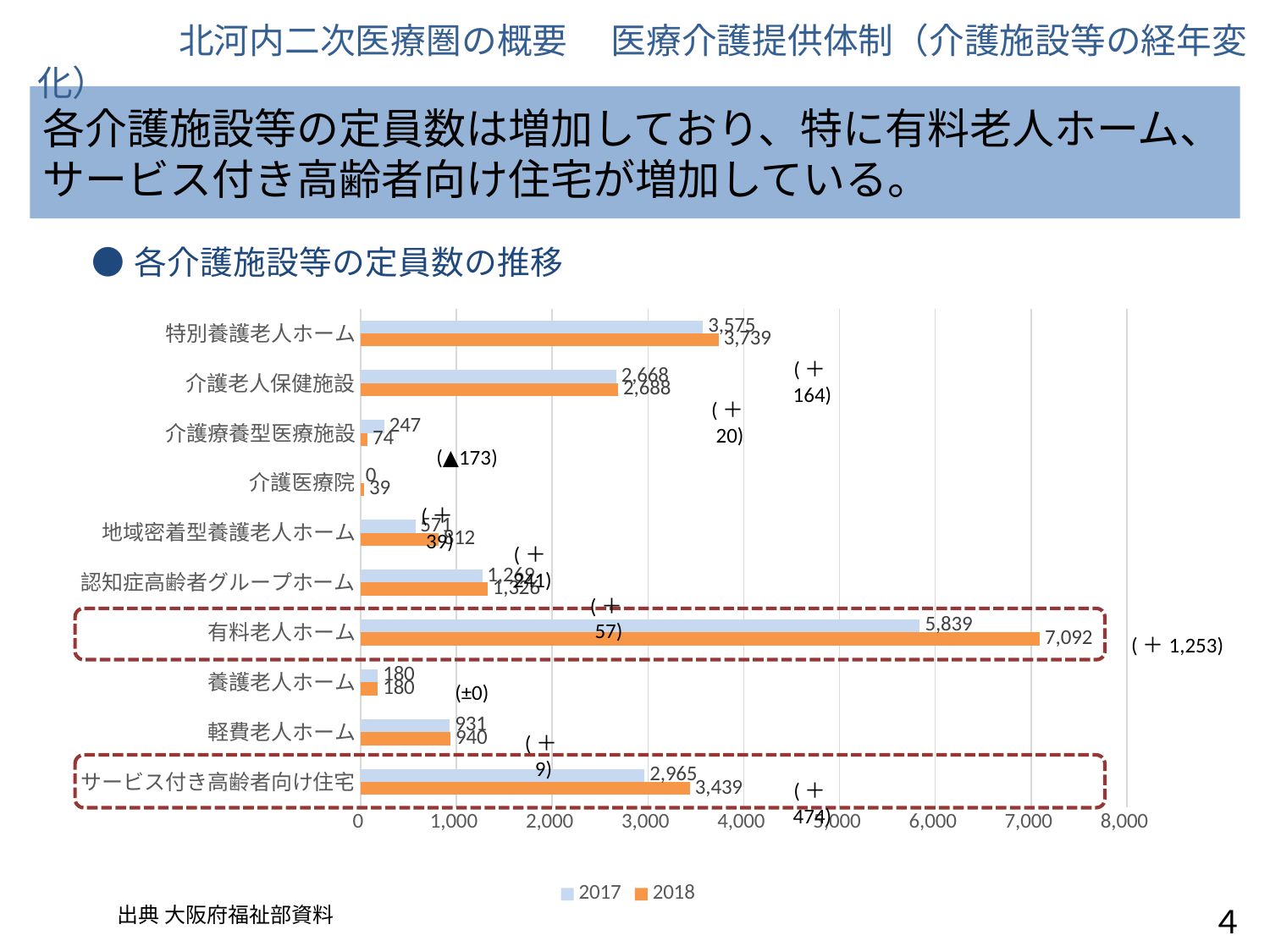
What type of chart is shown on the slide? bar chart Which colour represents the 2018 series in the chart? orange What is the 2017 value for 特別養護老人ホーム? 3,575 Which category has the highest 2018 value? 有料老人ホーム What is the 2018 value for サービス付き高齢者向け住宅? 3,439 How many series does the legend list? 2 What is the 2018 value for 有料老人ホーム? 7,092 What is the difference between the 2018 and 2017 values for 有料老人ホーム? 1,253 Is the 2018 value for 介護老人保健施設 greater or less than 3,000? less Which category has the lowest 2017 value? 介護医療院 Which is larger, the 2017 value for 介護療養型医療施設 or its 2018 value? 2017 How many facility categories are plotted on the chart? 10